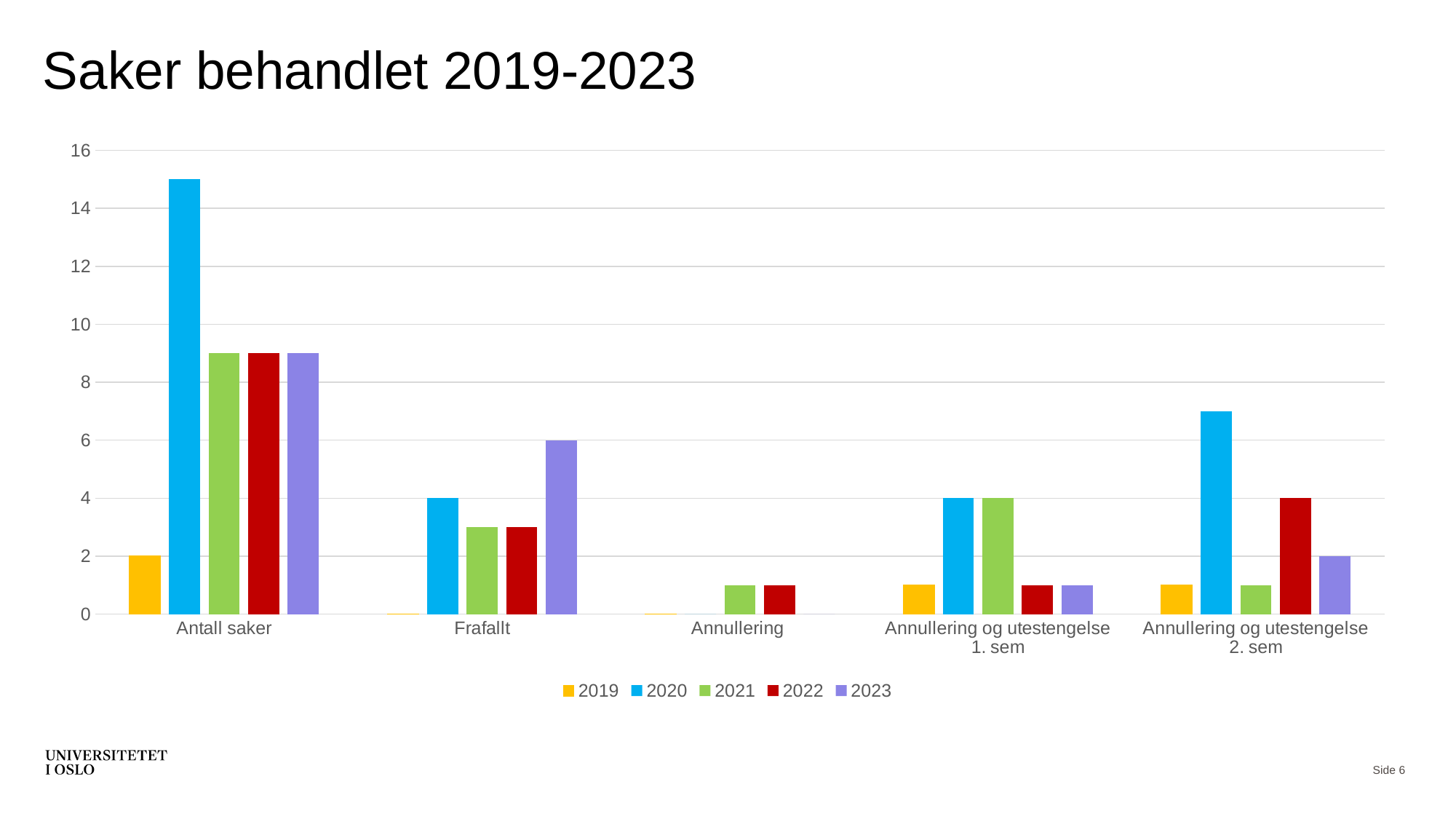
Is the value for 2020 in the Antall saker category greater or less than 14? greater How many series does the legend list? 5 What is the value for 2019 in the Antall saker category? 2 What is the difference between the 2023 and 2020 values in the Frafallt category? 2 In the Frafallt category, which is larger: the value for 2022 or the value for 2023? 2023 Which year has the highest value in the Antall saker category? 2020 What is the value for 2020 in the Frafallt category? 4 What is the value for 2023 in the Annullering og utestengelse 2. sem category? 2 What is the value for 2023 in the Frafallt category? 6 What kind of chart is shown on the slide? bar chart Is the value for 2020 in the Annullering og utestengelse 2. sem category greater or less than 6? greater How many categories are shown on the x axis? 5